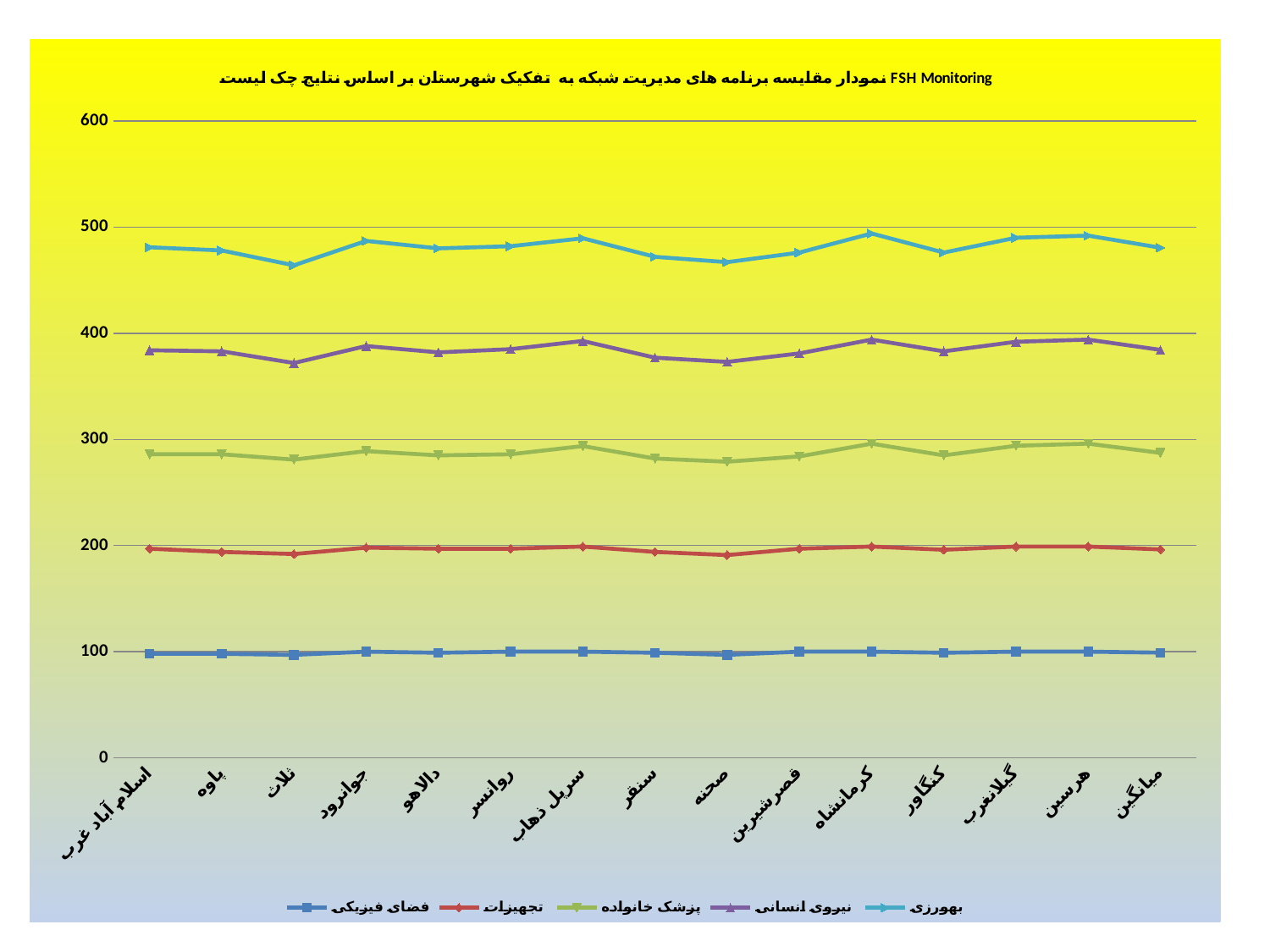
Is the value for نیروی انسانی at کرمانشاه greater or less than 400? less How many series does the legend list? 5 How many categories are shown along the x axis? 15 Is the value for بهورزی at ثلاث greater or less than 500? less Is the value for پزشک خانواده at صحنه greater or less than 300? less Which series is drawn with the red line in the legend? تجهیزات What kind of chart is shown on the slide? line chart